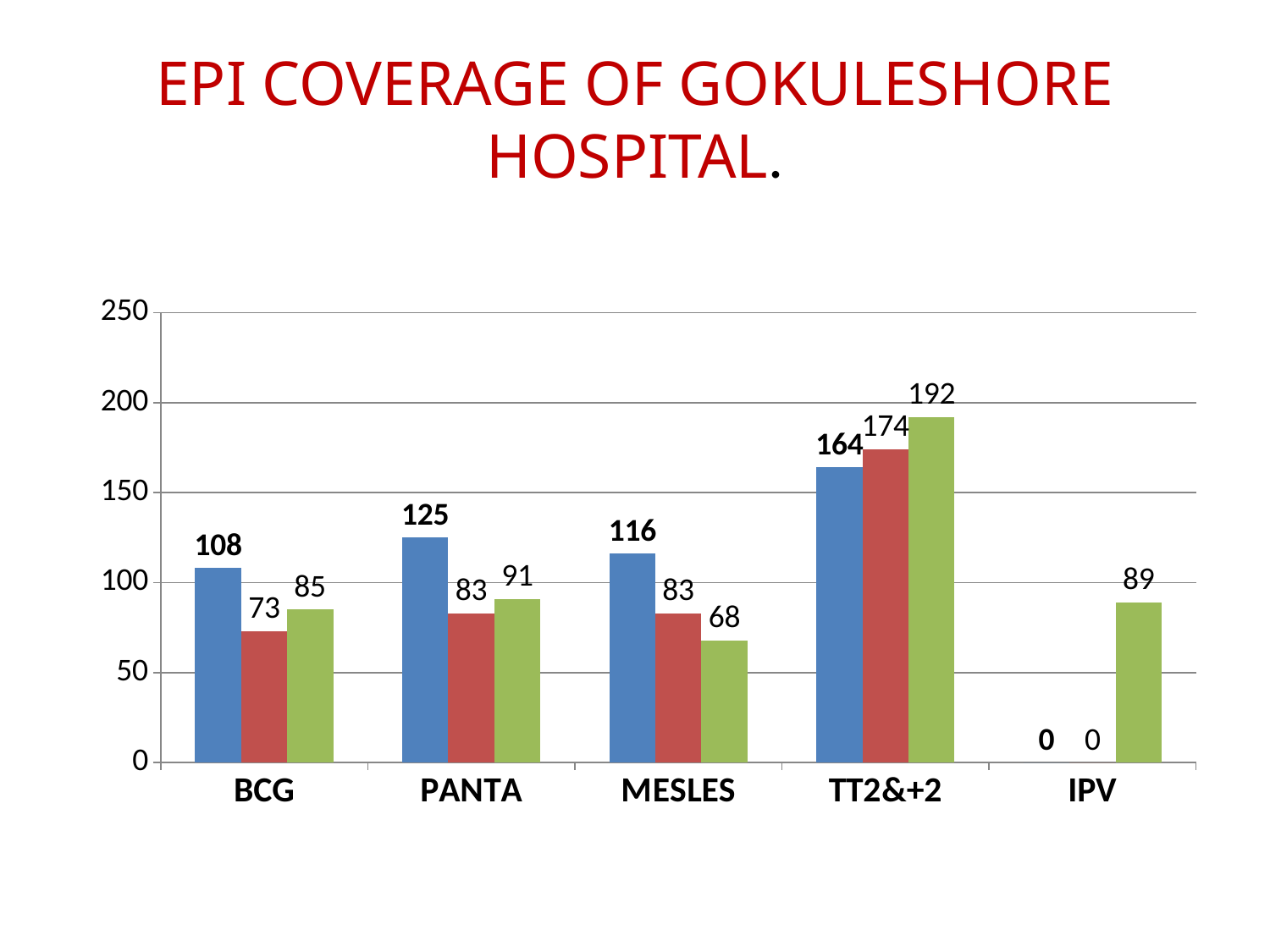
Is the value of the red bar for TT2&+2 greater or less than 150? greater What is the value of the red bar for MESLES? 83 What is the value of the green bar for TT2&+2? 192 Which is larger for BCG, the red bar or the green bar? the green bar Which category has the lowest green bar? MESLES What is the title of the chart on the slide? EPI COVERAGE OF GOKULESHORE HOSPITAL. Which category has the highest blue bar? TT2&+2 What is the value of the blue bar for BCG? 108 What kind of chart is shown on the slide? bar chart What is the difference between the blue bar and the red bar for PANTA? 42 How many categories are shown on the x axis? 5 What is the value of the green bar for IPV? 89